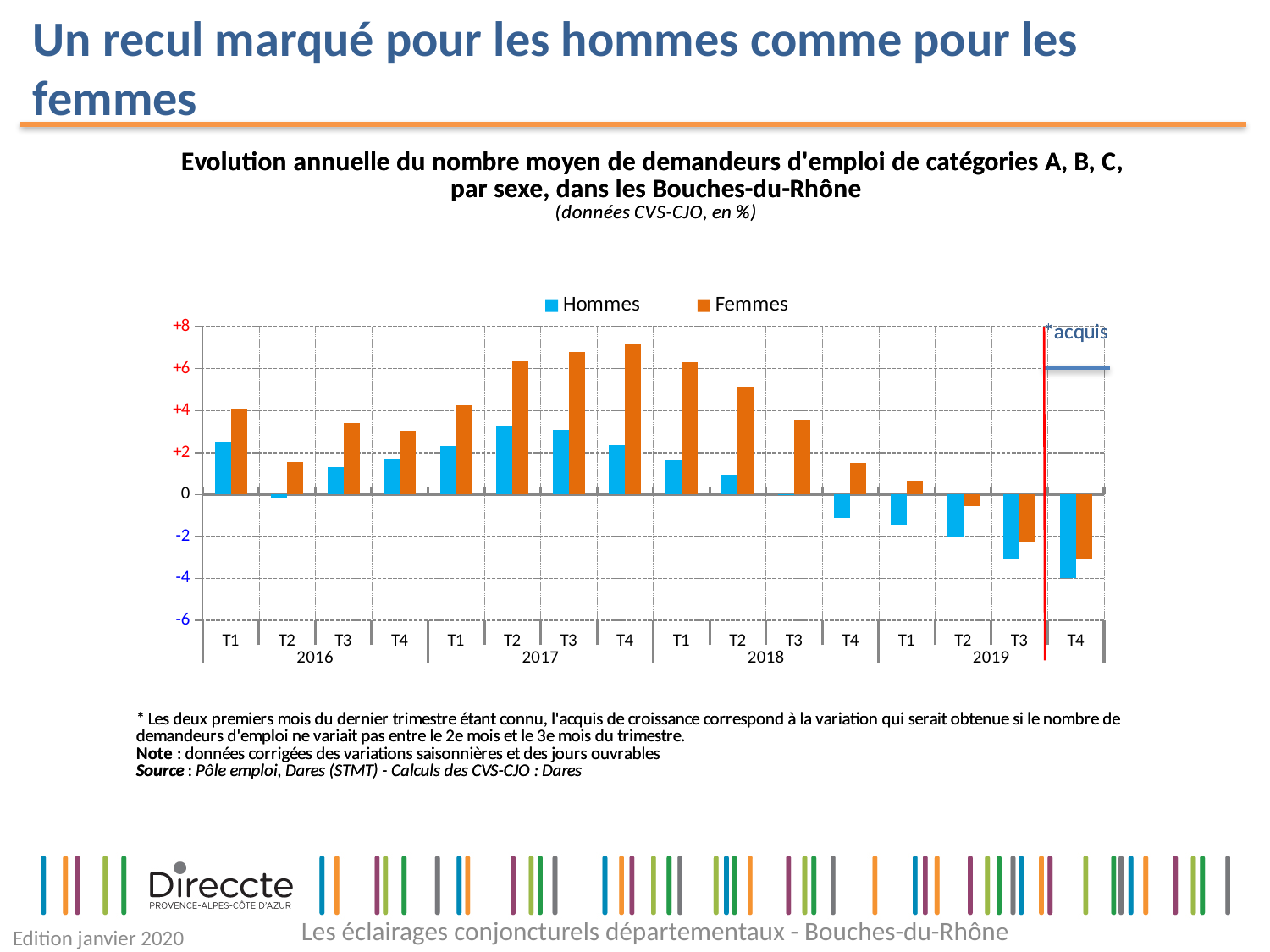
What kind of chart is shown on the slide? bar chart How many series does the legend list? 2 Which is larger for Hommes, the value in T1 2016 or the value in T2 2016? T1 2016 Do the Hommes values rise or fall from T1 2018 to T4 2019? fall Is the value for Femmes in T1 2016 greater or less than +2? greater Which colour represents the Hommes series? blue Is the value for Hommes in T4 2019 greater or less than -2? less What are the two series named in the legend? Hommes and Femmes How many quarters are plotted along the x axis? 16 Is the value for Femmes in T4 2017 greater or less than +6? greater In which quarter is the Hommes value lowest? T4 2019 In T2 2017, which series has the larger value, Hommes or Femmes? Femmes